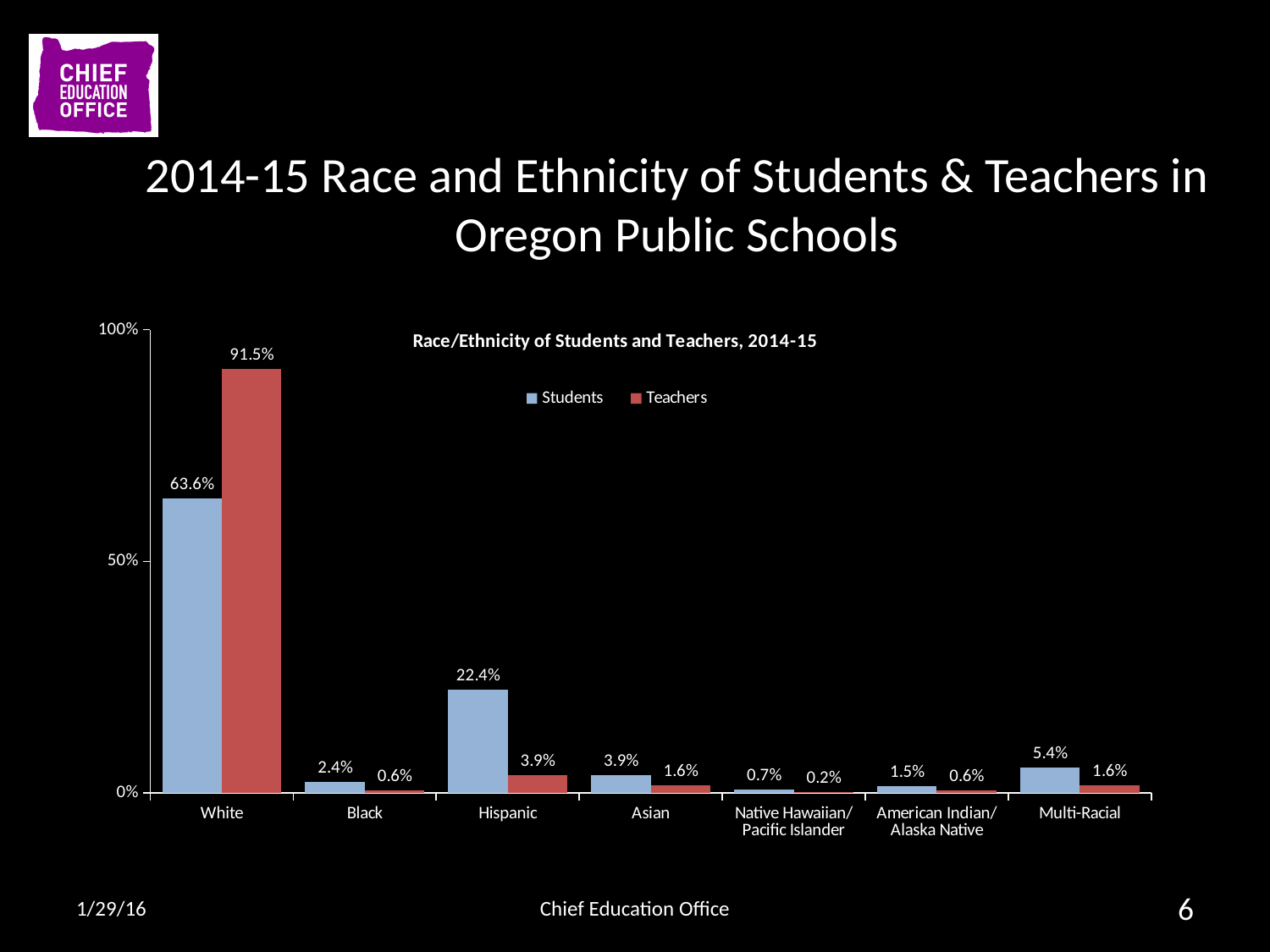
Which is larger for Hispanic: the Students value or the Teachers value? Students What kind of chart is shown on the slide? bar chart What is the title of the chart? Race/Ethnicity of Students and Teachers, 2014-15 What percentage of teachers are Hispanic? 3.9% Is the Students value for White greater or less than 50%? greater Which category has the highest value for Teachers? White What percentage of students are White? 63.6% What is the value for Multi-Racial in the Students series? 5.4% How many series does the legend list? 2 How many race/ethnicity categories are shown on the x axis? 7 Which category has the lowest value for Teachers? Native Hawaiian/ Pacific Islander What is the difference between the Teachers and Students values for White? 27.9%